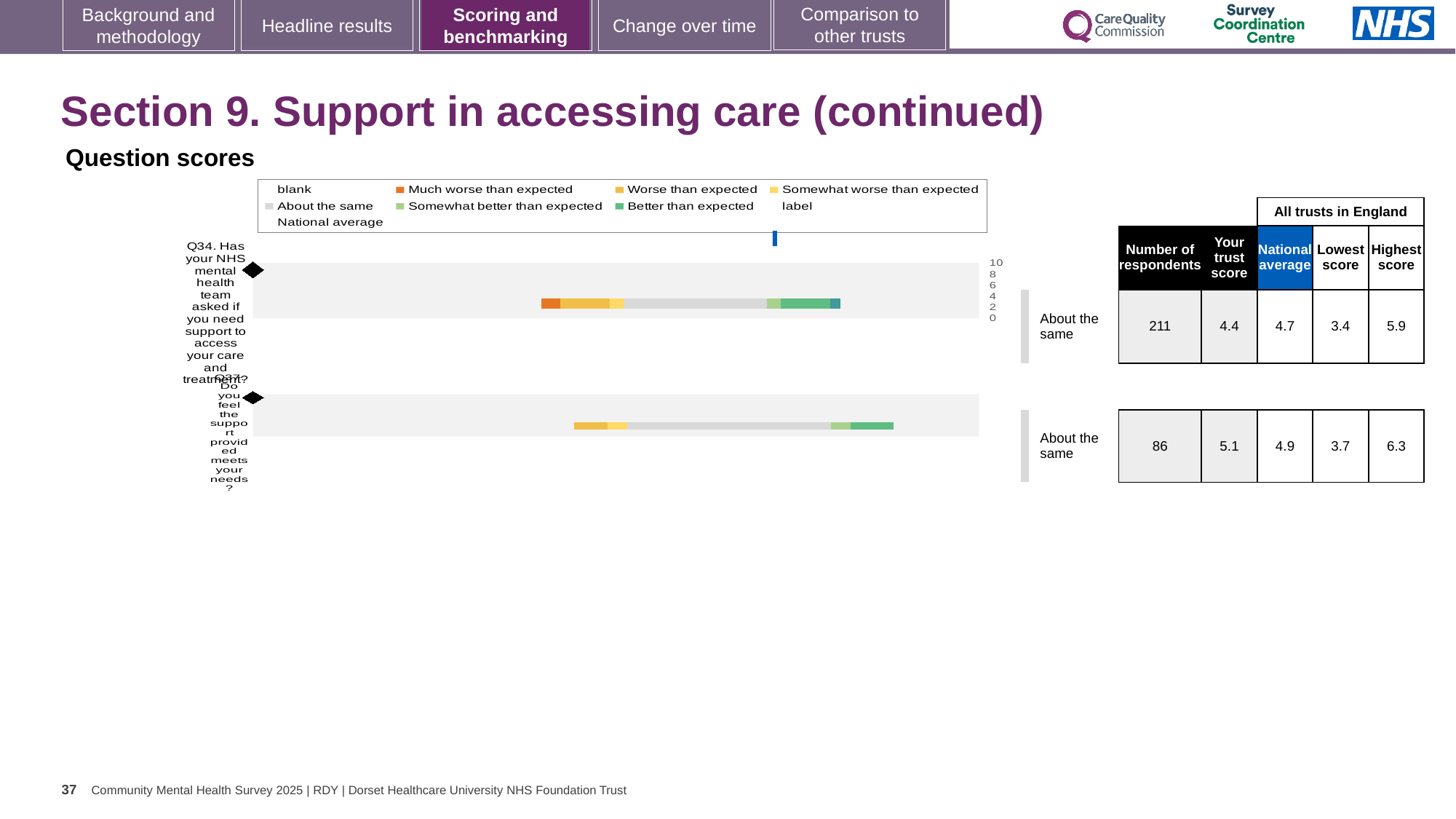
For Q37, which is larger: the trust score or the national average? trust score What is the trust score for Q37 (Do you feel the support provided meets your needs?)? 5.1 What is the highest score among all trusts in England for Q37? 6.3 What benchmark category is shown for Q34 next to the chart? About the same What is the difference between the highest score and the lowest score for Q34? 2.5 What kind of chart is used to show the question scores on this slide? bar chart In the chart legend, what colour represents 'Much worse than expected'? orange What is the number of respondents for Q34 in the table next to the chart? 211 Which question has the higher trust score, Q34 or Q37? Q37 How many questions (bars) are plotted in the question scores chart? 2 What is the national average score for Q34? 4.7 In the chart legend, what colour represents 'Better than expected'? green